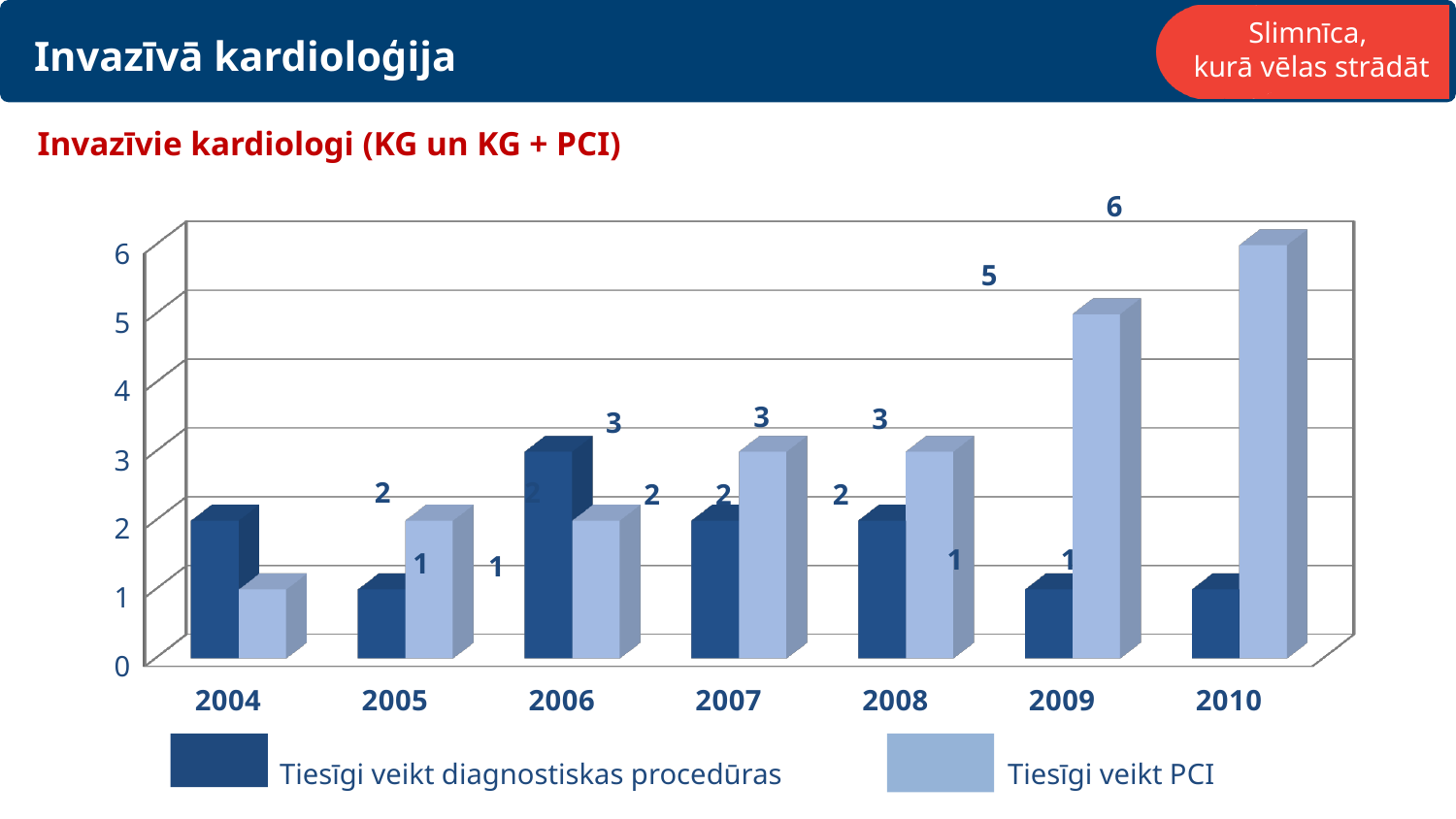
What is the difference between the 'Tiesīgi veikt PCI' value and the 'Tiesīgi veikt diagnostiskas procedūras' value in 2010? 5 In which year is the 'Tiesīgi veikt PCI' value highest? 2010 How many series does the legend list? 2 What is the value for 'Tiesīgi veikt diagnostiskas procedūras' in 2006? 3 Does the 'Tiesīgi veikt PCI' value rise or fall from 2008 to 2010? rise Is the value for 'Tiesīgi veikt PCI' in 2009 greater or less than 4? greater In 2004, which series has the larger value: 'Tiesīgi veikt diagnostiskas procedūras' or 'Tiesīgi veikt PCI'? Tiesīgi veikt diagnostiskas procedūras How many years are shown on the x axis? 7 What is the value for 'Tiesīgi veikt PCI' in 2010? 6 In which year is the 'Tiesīgi veikt diagnostiskas procedūras' value highest? 2006 What is the value for 'Tiesīgi veikt PCI' in 2009? 5 What kind of chart is shown on the slide? bar chart